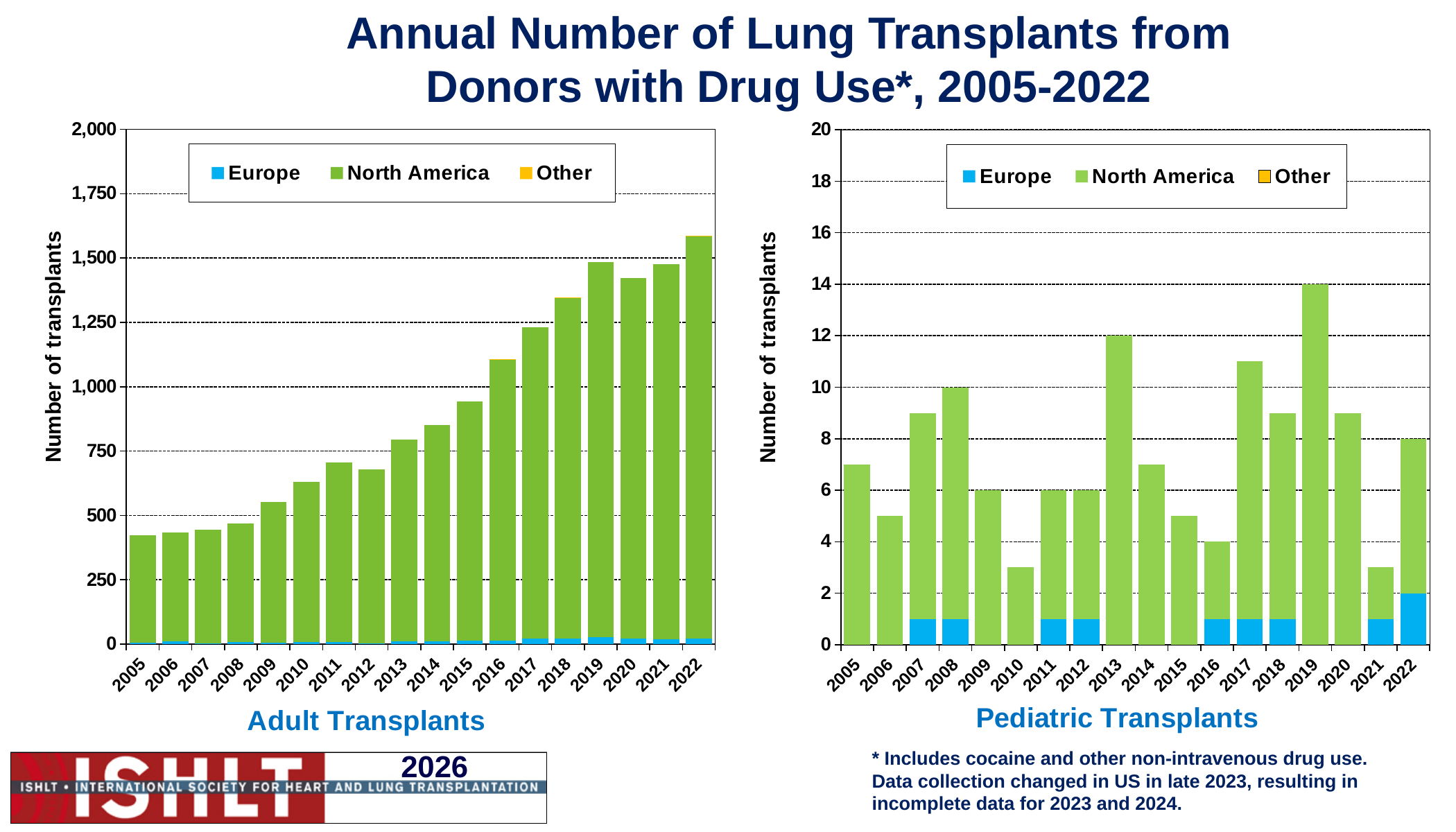
In the Pediatric Transplants chart, which year has the highest total number of transplants? 2019 In the Pediatric Transplants chart, which is larger, the total for 2013 or the total for 2014? 2013 In the Adult Transplants chart, do the totals generally rise or fall from 2005 to 2022? rise In the Pediatric Transplants chart, what is the total number of transplants in 2013? 12 What kind of chart is the Adult Transplants chart? bar chart In the Pediatric Transplants chart, what is the total number of transplants in 2008? 10 In the Adult Transplants chart, which year has the highest total number of transplants? 2022 How many series does the legend of the Pediatric Transplants chart list? 3 In the Pediatric Transplants chart, what is the total number of transplants in 2019? 14 In the Adult Transplants chart, is the total for 2022 greater or less than 1,500? greater How many years are shown on the x axis of the Adult Transplants chart? 18 In the Adult Transplants chart, is the total for 2005 greater or less than 500? less